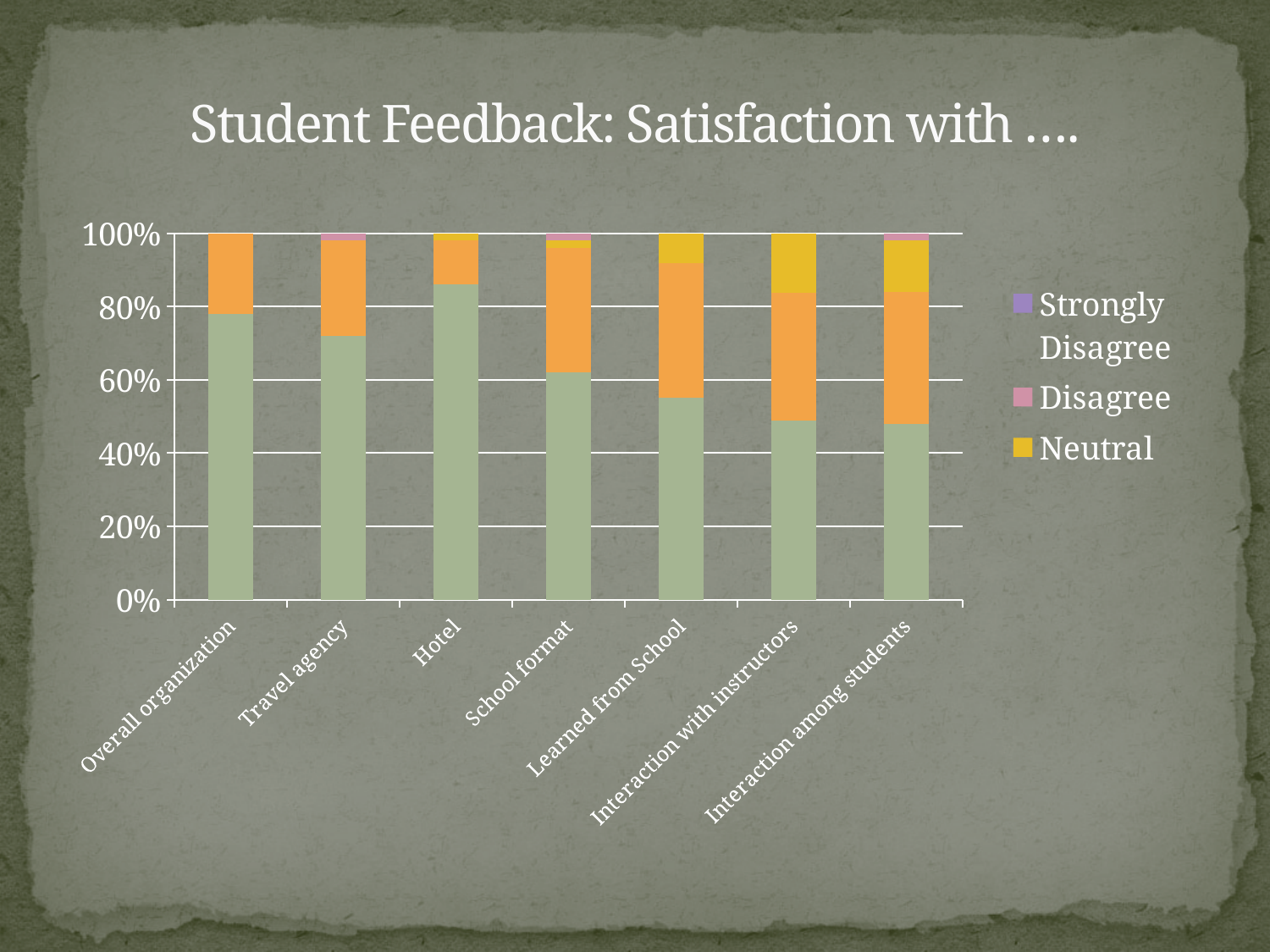
Is the top of the bottom (green) segment for Interaction with instructors greater or less than 60%? less Which category has the tallest bottom (green) segment? Hotel How many categories are shown along the x axis of the chart? 7 What kind of chart is shown on the slide? Stacked bar chart Is the top of the bottom (green) segment for Overall organization greater or less than 60%? greater Is the top of the bottom (green) segment for Learned from School greater or less than 60%? less How many series does the visible legend list? 3 What is the title of the chart? Student Feedback: Satisfaction with …. Which has the taller bottom (green) segment, Travel agency or Learned from School? Travel agency Which has the taller bottom (green) segment, Hotel or School format? Hotel Which legend entry is shown in yellow? Neutral